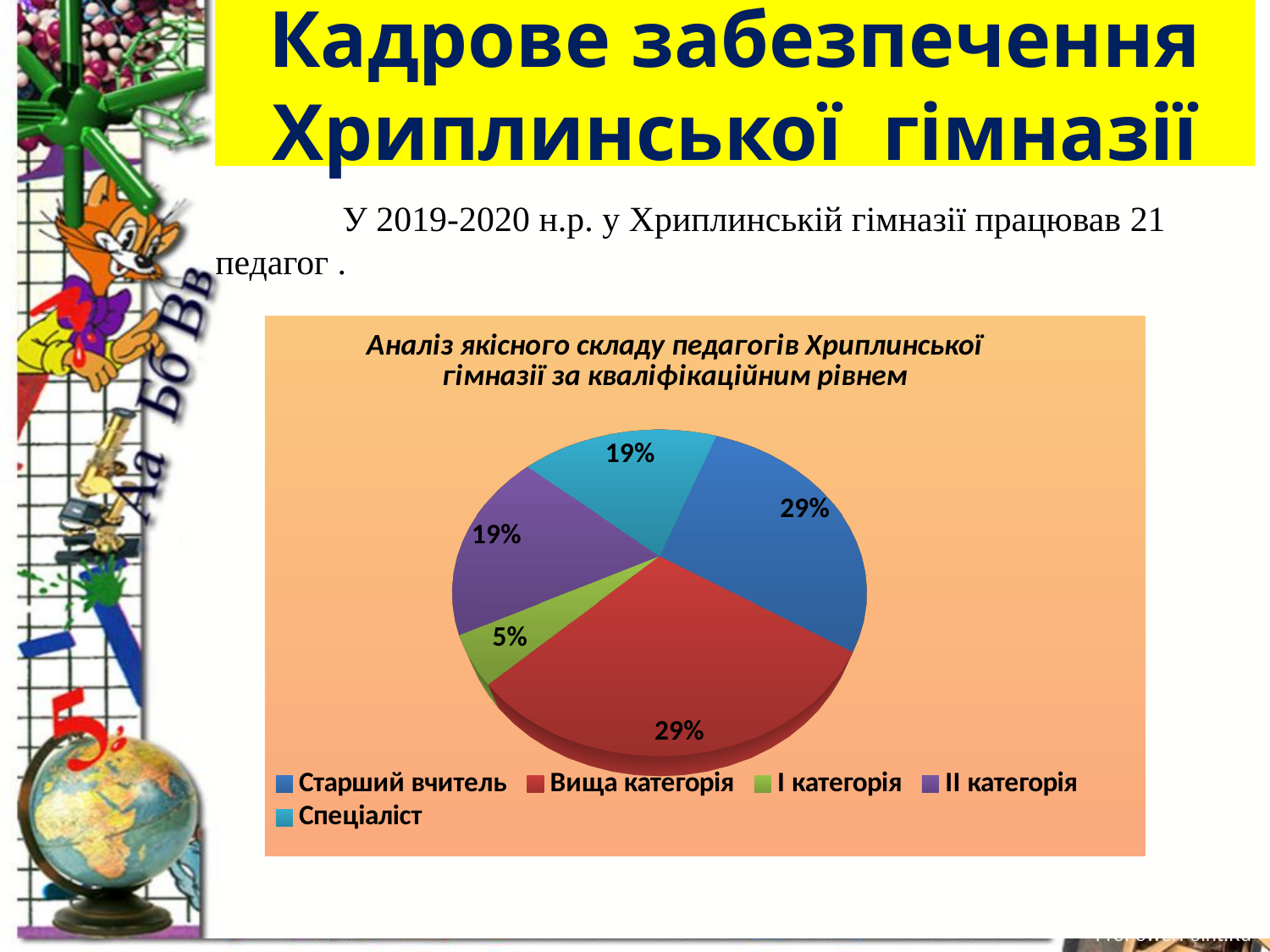
What share of the pie does the "Спеціаліст" slice represent? 19% What is the value shown for "І категорія"? 5% What kind of chart is shown on the slide? pie chart What share of the pie does the "Старший вчитель" slice represent? 29% What is the value shown for "Вища категорія"? 29% What is the title of the chart? Аналіз якісного складу педагогів Хриплинської гімназії за кваліфікаційним рівнем Which category has the smallest slice of the pie? І категорія What is the difference in percentage points between the "Вища категорія" slice and the "І категорія" slice? 24 How many categories (slices) does the pie chart have? 5 Which is larger: the slice for "ІІ категорія" or the slice for "І категорія"? ІІ категорія What is the value shown for "ІІ категорія"? 19% Which is larger: the slice for "Старший вчитель" or the slice for "І категорія"? Старший вчитель